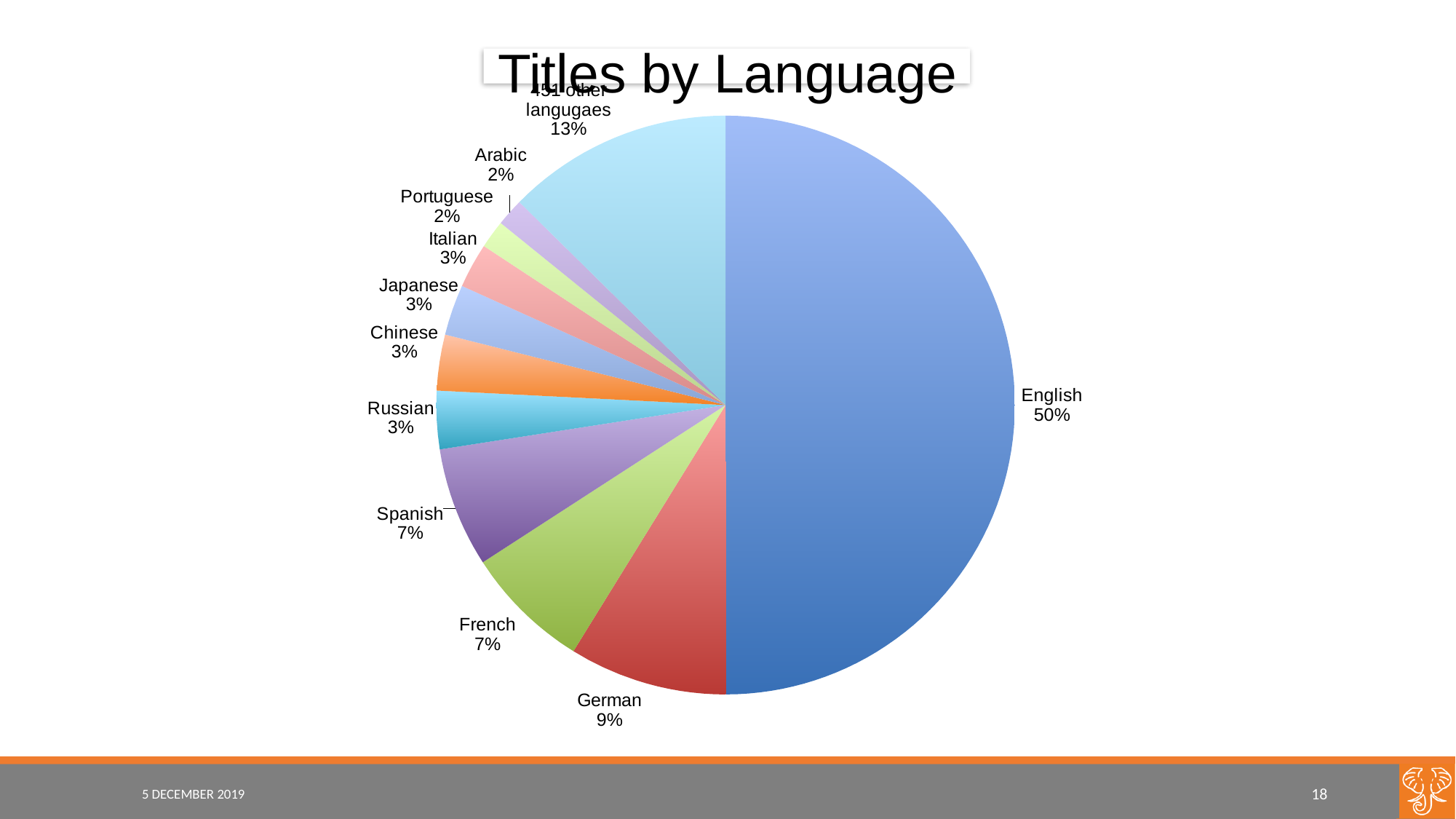
What is the title of the chart? Titles by Language What share of titles is English? 50% What share of titles is Russian? 3% What is the difference between the share for French and the share for Arabic? 5% What share of titles is Spanish? 7% Which language has the largest share of titles? English Which is larger, the share for German or the share for French? German What kind of chart is shown on the slide? pie chart How many slices does the pie chart have? 11 What is the difference between the share for English and the share for German? 41% What share of titles is German? 9% What share of titles is Portuguese? 2%